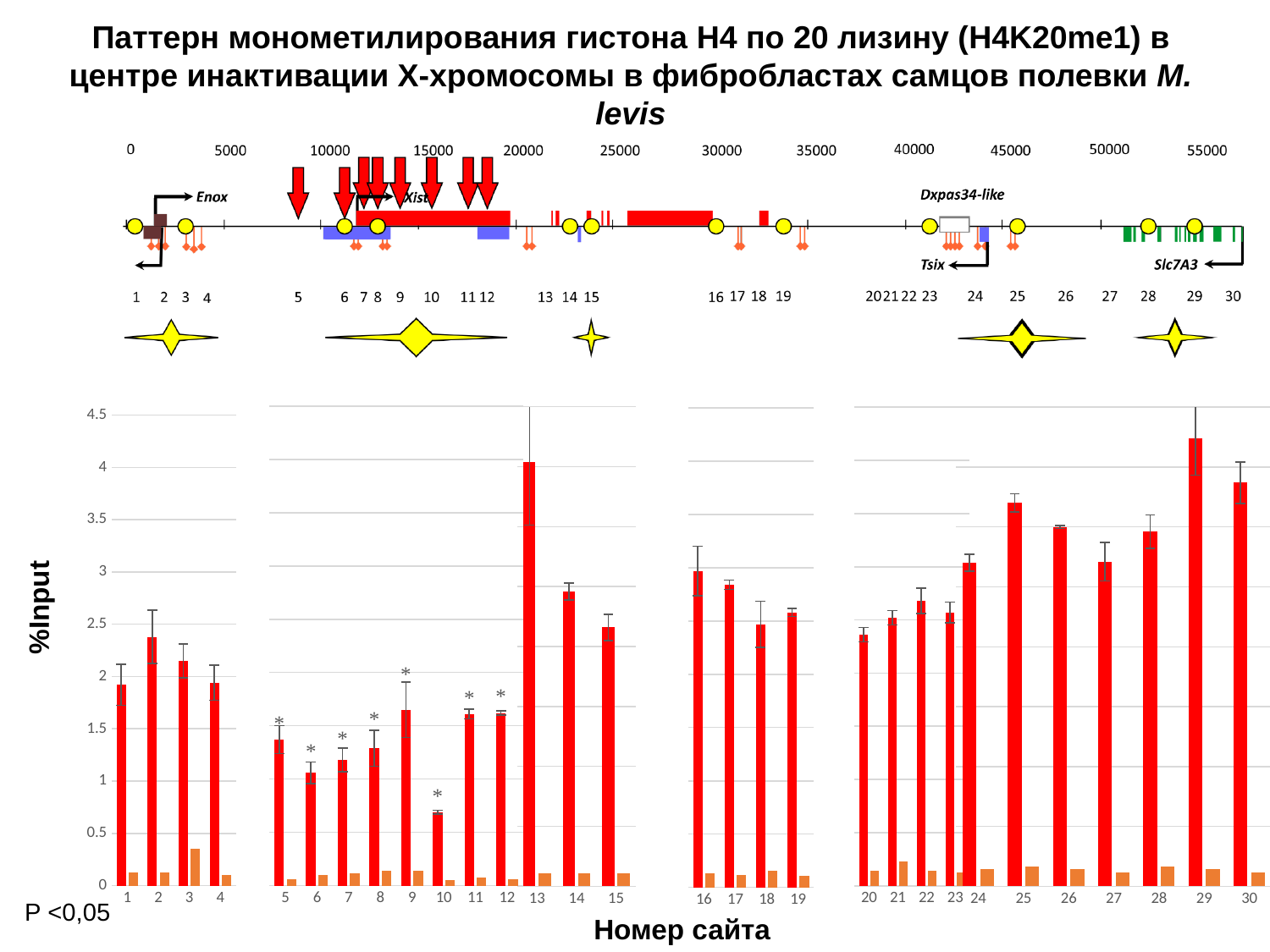
Is the red bar value for site 30 greater or less than 3.5? greater What is the label of the y axis of the bar chart? %Input Which has the larger red bar, site 1 or site 10? site 1 What is the label of the x axis of the bar chart? Номер сайта What kind of chart is shown at the bottom of the slide? bar chart Is the red bar value for site 29 greater or less than 4? greater Is the red bar value for site 2 greater or less than 2? greater Which site has the lowest red bar in the bar chart? 10 How many sites (categories) are plotted along the x axis of the bar chart? 30 Which has the larger red bar, site 13 or site 14? site 13